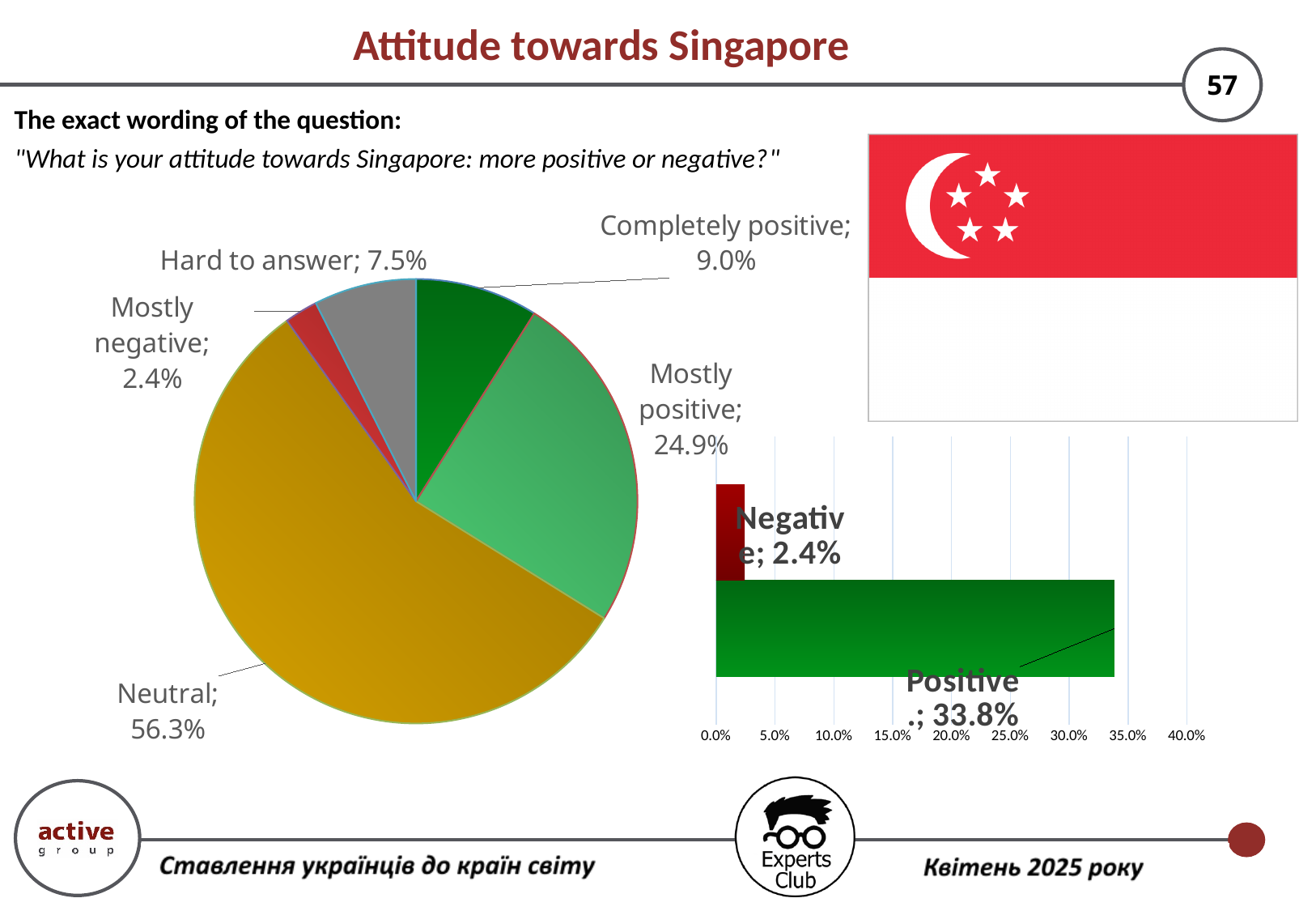
How many slices does the pie chart on the left have? 5 In the bar chart on the right, what is the difference between Positive and Negative? 31.4% What type of chart is shown on the right side of the slide? Bar chart In the pie chart on the left, what is the value for Mostly positive? 24.9% In the pie chart on the left, what is the difference between Mostly positive and Completely positive? 15.9% In the pie chart on the left, what is the value for Hard to answer? 7.5% In the bar chart on the right, what is the value for Negative? 2.4% In the bar chart on the right, what is the value for Positive? 33.8% In the pie chart on the left, which category has the smallest slice? Mostly negative In the pie chart on the left, what is the value for Neutral? 56.3% In the pie chart on the left, which category has the largest slice? Neutral In the pie chart on the left, which is larger: Hard to answer or Completely positive? Completely positive